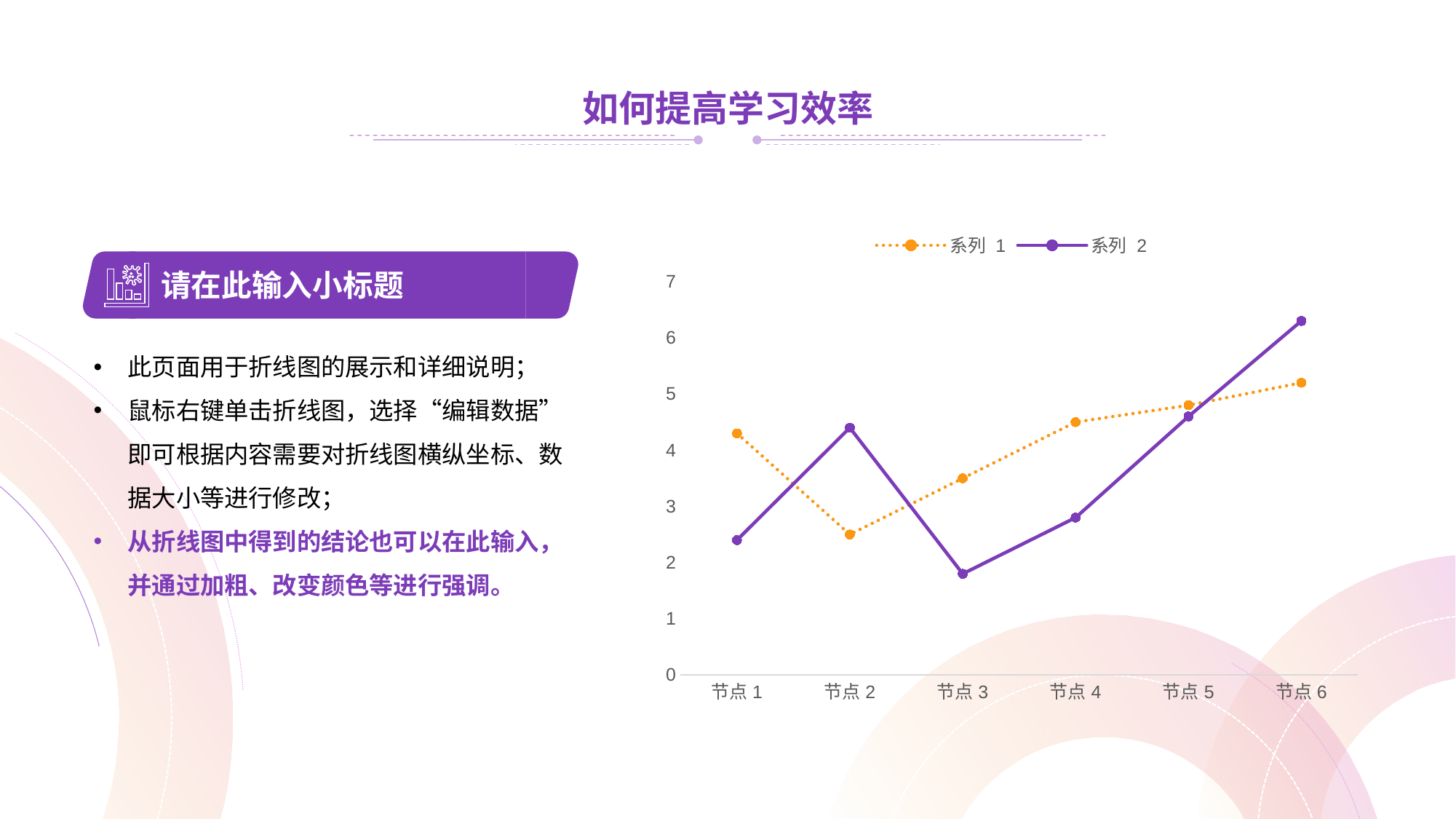
How many series does the chart legend list? 2 How many categories are shown on the x axis of the chart? 6 What kind of chart is shown on the slide? line chart Does 系列 2 rise or fall from 节点 3 to 节点 6? rise At 节点 2, which series has the larger value, 系列 1 or 系列 2? 系列 2 Which series is drawn with a dotted orange line? 系列 1 Is the value for 系列 2 at 节点 3 greater or less than 2? less Is the value for 系列 2 at 节点 6 greater or less than 5? greater At which category does 系列 2 reach its highest value? 节点 6 At which category does 系列 2 reach its lowest value? 节点 3 At 节点 1, which series has the larger value, 系列 1 or 系列 2? 系列 1 At which category does 系列 1 reach its lowest value? 节点 2